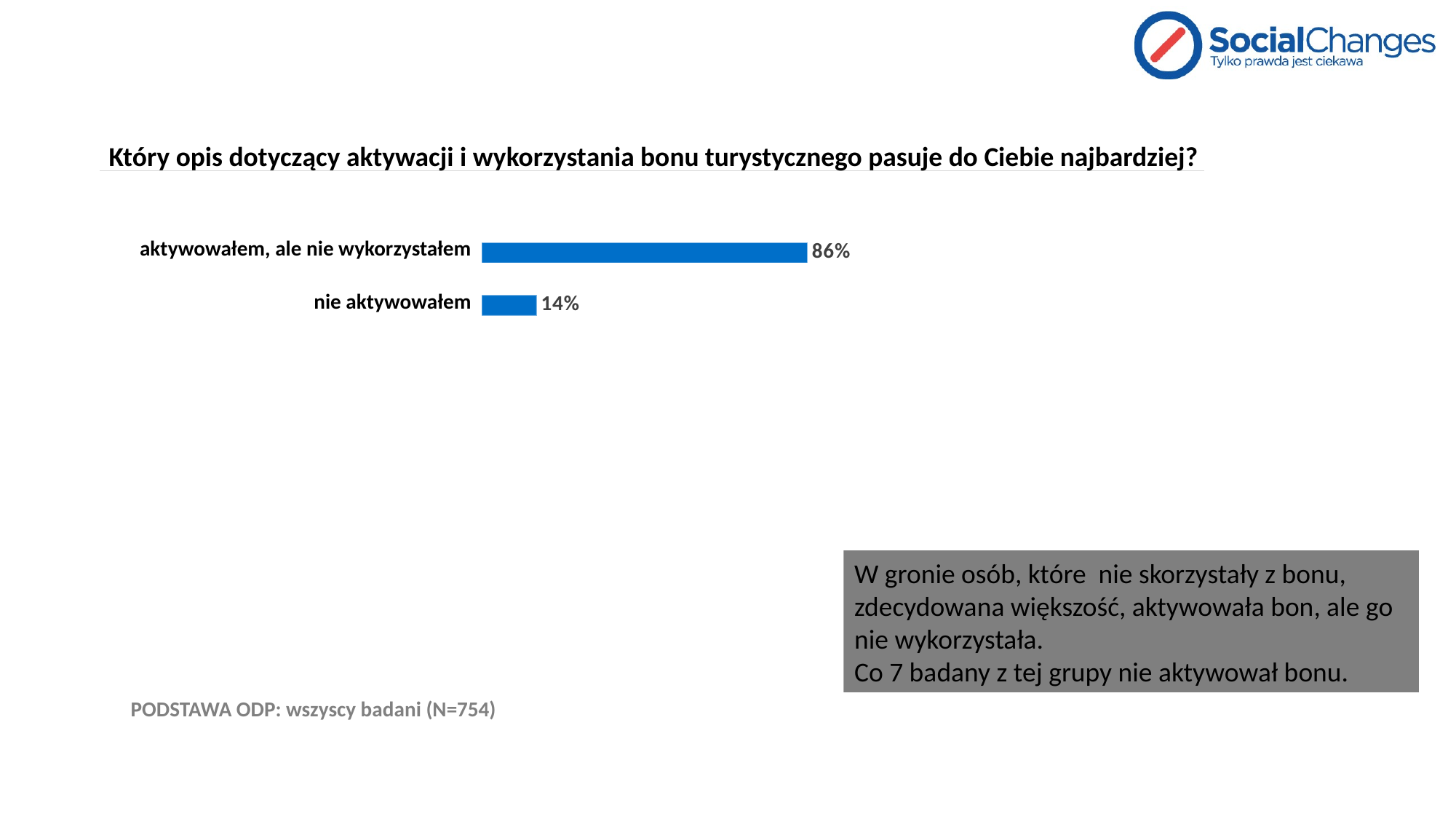
What is the total of the two values shown in the chart? 100% Which category has the lowest value? nie aktywowałem What is the title of the chart? Który opis dotyczący aktywacji i wykorzystania bonu turystycznego pasuje do Ciebie najbardziej? What is the difference between the values for "aktywowałem, ale nie wykorzystałem" and "nie aktywowałem"? 72 percentage points What is the value for "nie aktywowałem"? 14% How many categories are shown in the chart? 2 Which category has the highest value? aktywowałem, ale nie wykorzystałem Which is larger: the value for "nie aktywowałem" or the value for "aktywowałem, ale nie wykorzystałem"? aktywowałem, ale nie wykorzystałem What is the sample size (N) stated in the base note below the chart? 754 What kind of chart is shown on the slide? Bar chart What is the value for "aktywowałem, ale nie wykorzystałem"? 86%